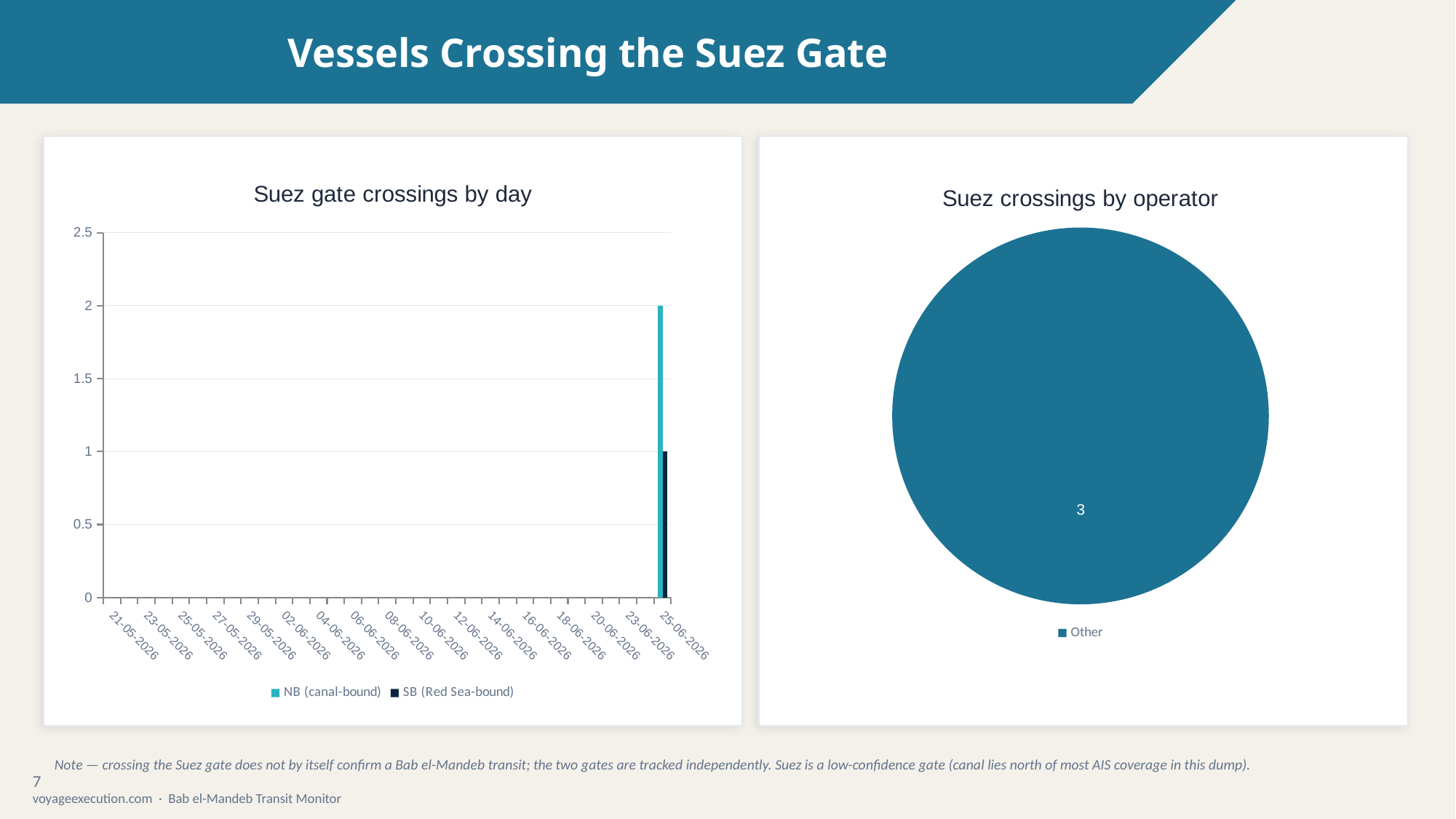
What kind of chart is "Suez crossings by operator"? pie chart In "Suez gate crossings by day", on which date is the NB (canal-bound) value highest? 25-06-2026 In "Suez gate crossings by day", how many series does the legend list? 2 What kind of chart is "Suez gate crossings by day"? bar chart In "Suez crossings by operator", how many slices does the pie have? 1 In "Suez gate crossings by day", is the NB (canal-bound) value on 25-06-2026 greater or less than 1.5? greater In "Suez crossings by operator", what is the value shown for Other? 3 In "Suez gate crossings by day", what is the NB (canal-bound) value on 25-06-2026? 2 In "Suez gate crossings by day", what are the two legend entries? NB (canal-bound) and SB (Red Sea-bound) In "Suez gate crossings by day", what is the difference between the NB (canal-bound) and SB (Red Sea-bound) values on 25-06-2026? 1 In "Suez gate crossings by day", what is the SB (Red Sea-bound) value on 25-06-2026? 1 In "Suez gate crossings by day", which series is larger on 25-06-2026, NB (canal-bound) or SB (Red Sea-bound)? NB (canal-bound)